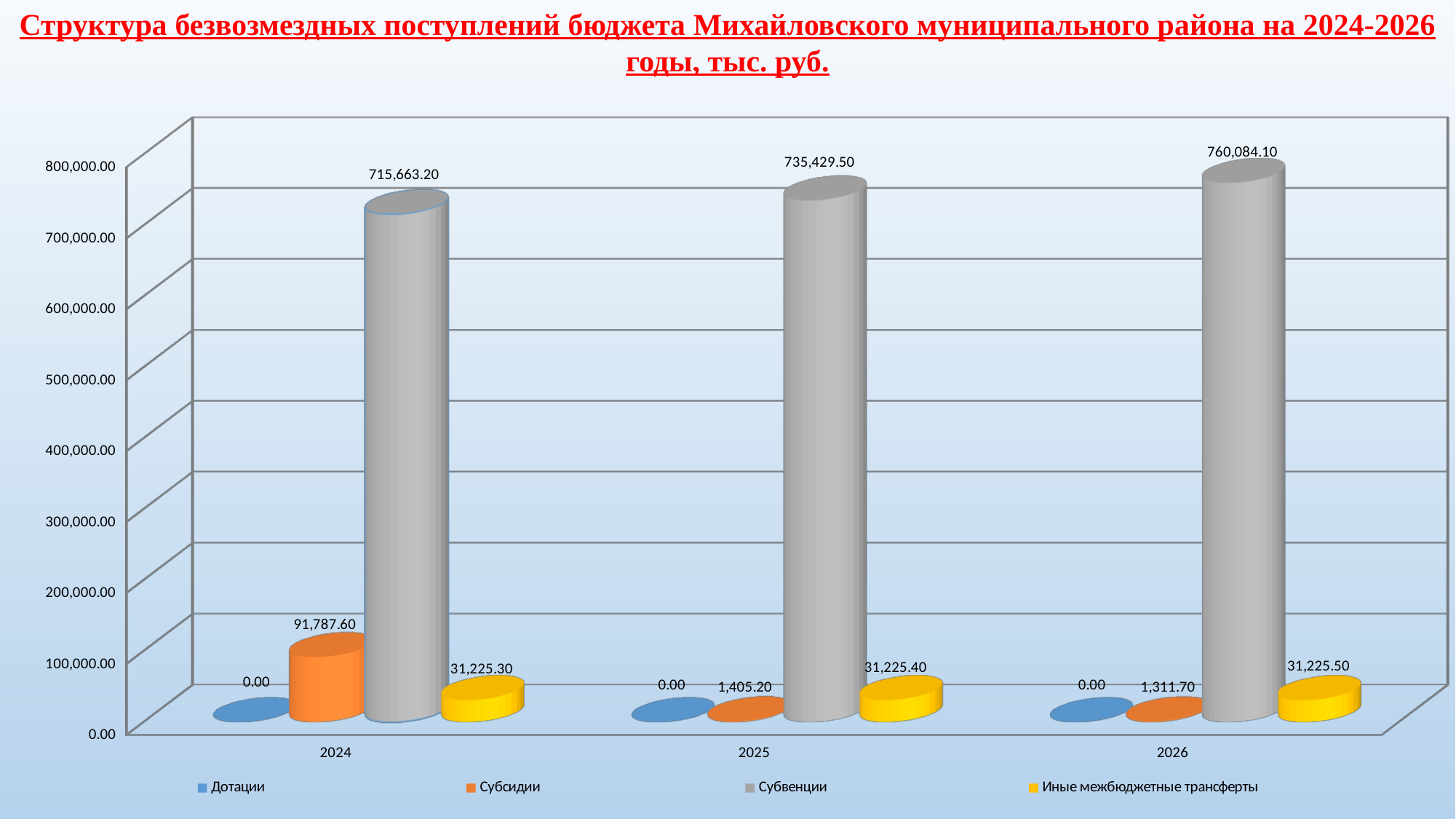
How many series does the legend list? 4 What is the difference between the Субсидии values for 2024 and 2025? 90,382.40 Do the values of Субвенции rise or fall from 2024 to 2026? Rise What is the value of Иные межбюджетные трансферты for 2026? 31,225.50 Which is larger in 2024: Субсидии or Иные межбюджетные трансферты? Субсидии What is the value of Дотации for 2024? 0.00 In which year is the value of Субсидии lowest? 2026 What is the value of Субвенции for 2024? 715,663.20 In which year is the value of Субвенции highest? 2026 What is the value of Субсидии for 2025? 1,405.20 What kind of chart is shown on the slide? Bar chart What is the difference between the Субвенции values for 2026 and 2024? 44,420.90